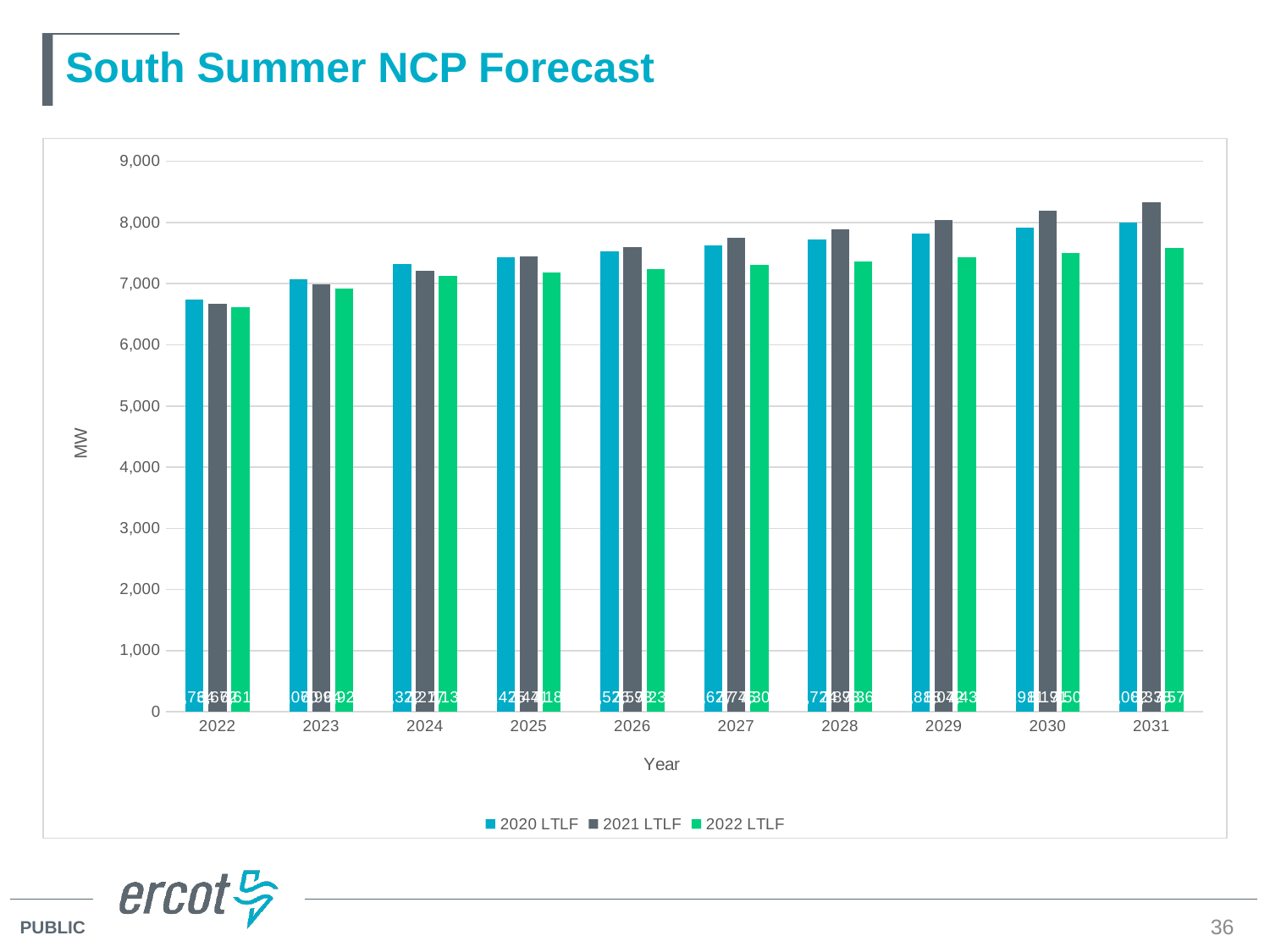
How many series does the legend list? 3 In 2028, which is larger: the 2021 LTLF value or the 2022 LTLF value? 2021 LTLF Is the 2020 LTLF value for 2025 greater or less than 7,000? greater What is the label on the y axis? MW Which series has the tallest bar in 2031? 2021 LTLF Do the 2020 LTLF values rise or fall from 2022 to 2031? rise Is the 2022 LTLF value for 2022 greater or less than 7,000? less In which year is the 2022 LTLF value lowest? 2022 How many years are shown on the x axis? 10 Is the 2021 LTLF value for 2031 greater or less than 8,000? greater What kind of chart is shown on the slide? bar chart